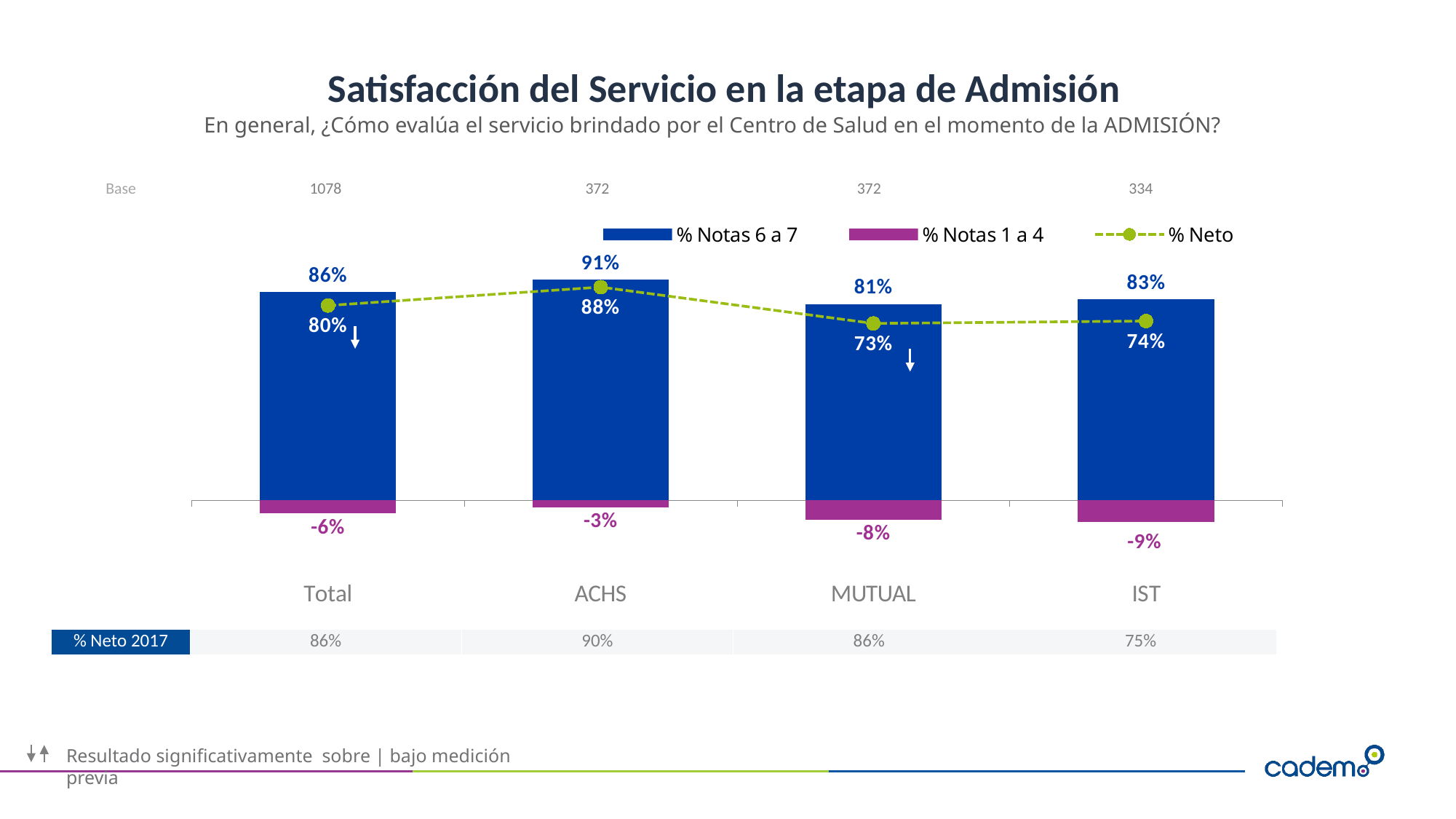
What kind of chart is shown on the slide? Bar chart with a line What is the value of % Notas 6 a 7 for ACHS? 91% What is the value of % Notas 1 a 4 for IST? -9% How many categories are shown on the x axis? 4 Which is larger, the % Neto value for Total or for IST? Total Which category has the lowest % Neto value? MUTUAL What is the % Neto 2017 value shown for ACHS? 90% What is the difference between the % Notas 6 a 7 values for ACHS and MUTUAL? 10 percentage points What is the base (sample size) shown for Total? 1078 How many series does the legend list? 3 Which category has the highest % Notas 6 a 7 value? ACHS What is the % Neto value for MUTUAL? 73%